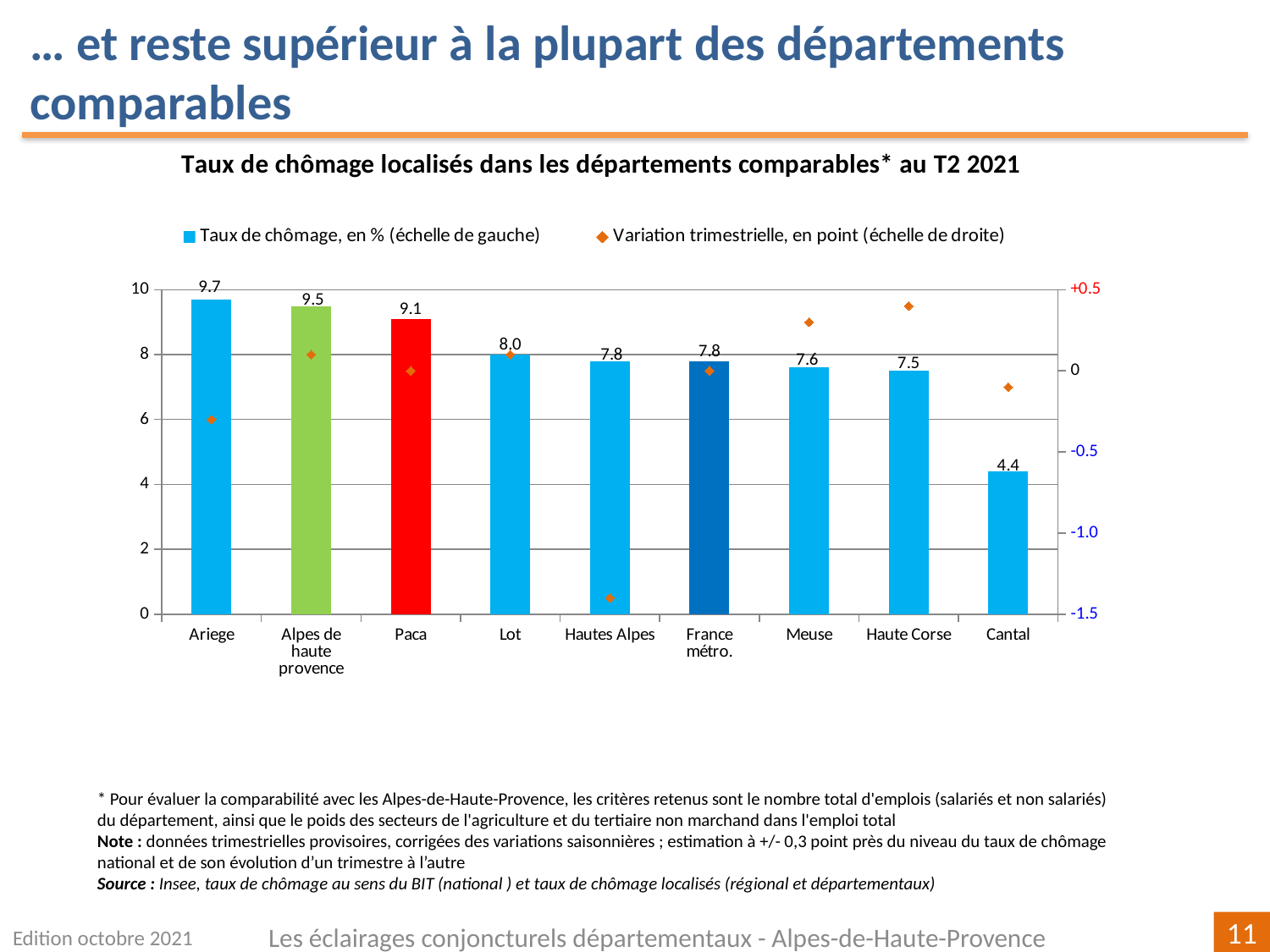
What is the unemployment rate shown for Alpes de haute provence? 9.5 Is the quarterly variation (Variation trimestrielle) for Haute Corse greater or less than 0? greater Which has a higher unemployment rate, Lot or Meuse? Lot What is the difference between the unemployment rates of Ariege and Paca? 0.6 How many series does the legend list? 2 Which category has the lowest unemployment rate in the chart? Cantal How many categories are shown on the x axis of the chart? 9 What is the unemployment rate shown for Cantal? 4.4 Which department has the highest unemployment rate in the chart? Ariege Is the quarterly variation (Variation trimestrielle) for Hautes Alpes greater or less than -1.0? less What is the title of the chart? Taux de chômage localisés dans les départements comparables* au T2 2021 What is the unemployment rate (Taux de chômage) shown for Ariege? 9.7